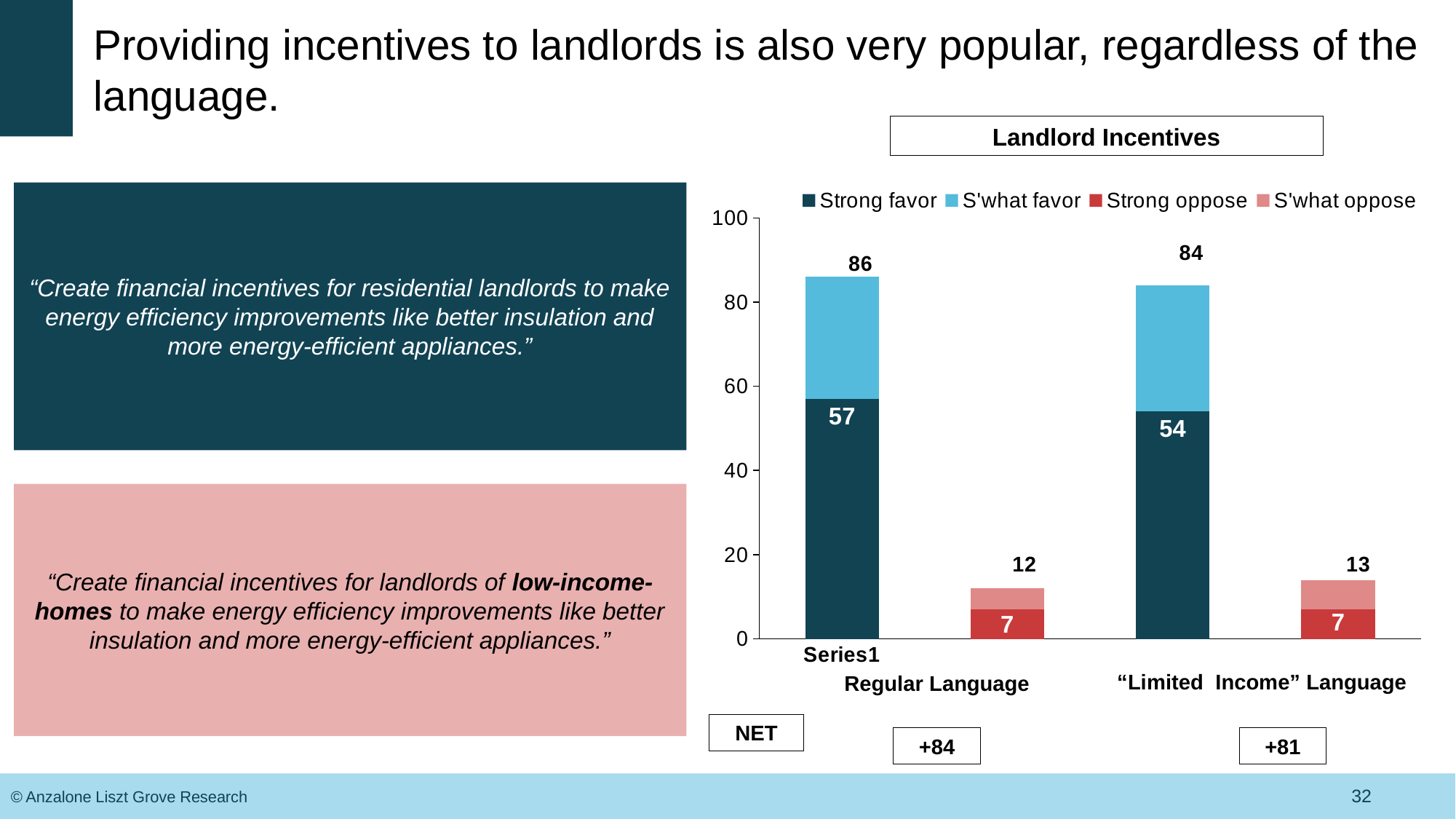
What is the NET value shown for "Limited Income" Language below the chart? +81 What is the difference between the total favor for Regular Language and the total favor for "Limited Income" Language? 2 Which language version has the higher Strong favor value, Regular Language or "Limited Income" Language? Regular Language What is the Strong favor value for Regular Language in the Landlord Incentives chart? 57 What is the Strong oppose value for Regular Language in the Landlord Incentives chart? 7 What type of chart is shown under the title 'Landlord Incentives'? stacked bar chart How many series does the legend of the Landlord Incentives chart list? 4 What is the Strong favor value for "Limited Income" Language in the Landlord Incentives chart? 54 What is the total favor (Strong favor plus S'what favor) shown above the favor bar for Regular Language? 86 Is the total favor value for "Limited Income" Language greater or less than 80? greater What is the NET value shown for Regular Language below the chart? +84 What is the total oppose shown above the oppose bar for "Limited Income" Language? 13